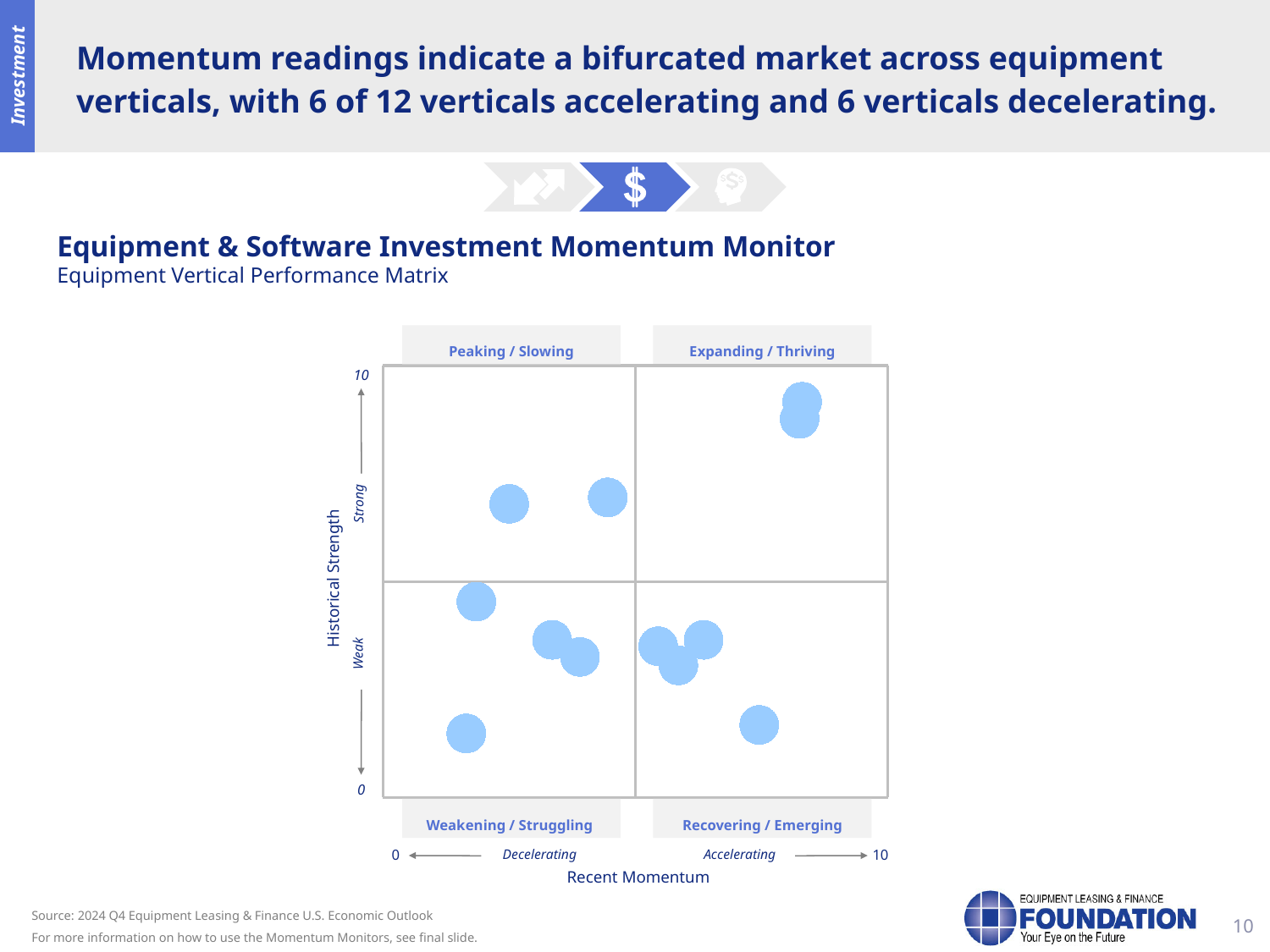
How many data points fall in the Weakening / Struggling quadrant? 4 How many data points fall in the Expanding / Thriving quadrant? 2 How many data points fall in the Peaking / Slowing quadrant? 2 What is the maximum value shown on the Recent Momentum axis? 10 Which quadrant contains more data points, Expanding / Thriving or Recovering / Emerging? Recovering / Emerging What is the title of the chart on the slide? Equipment & Software Investment Momentum Monitor What is the label of the vertical axis of the chart? Historical Strength What kind of chart is shown on the slide? Scatter plot